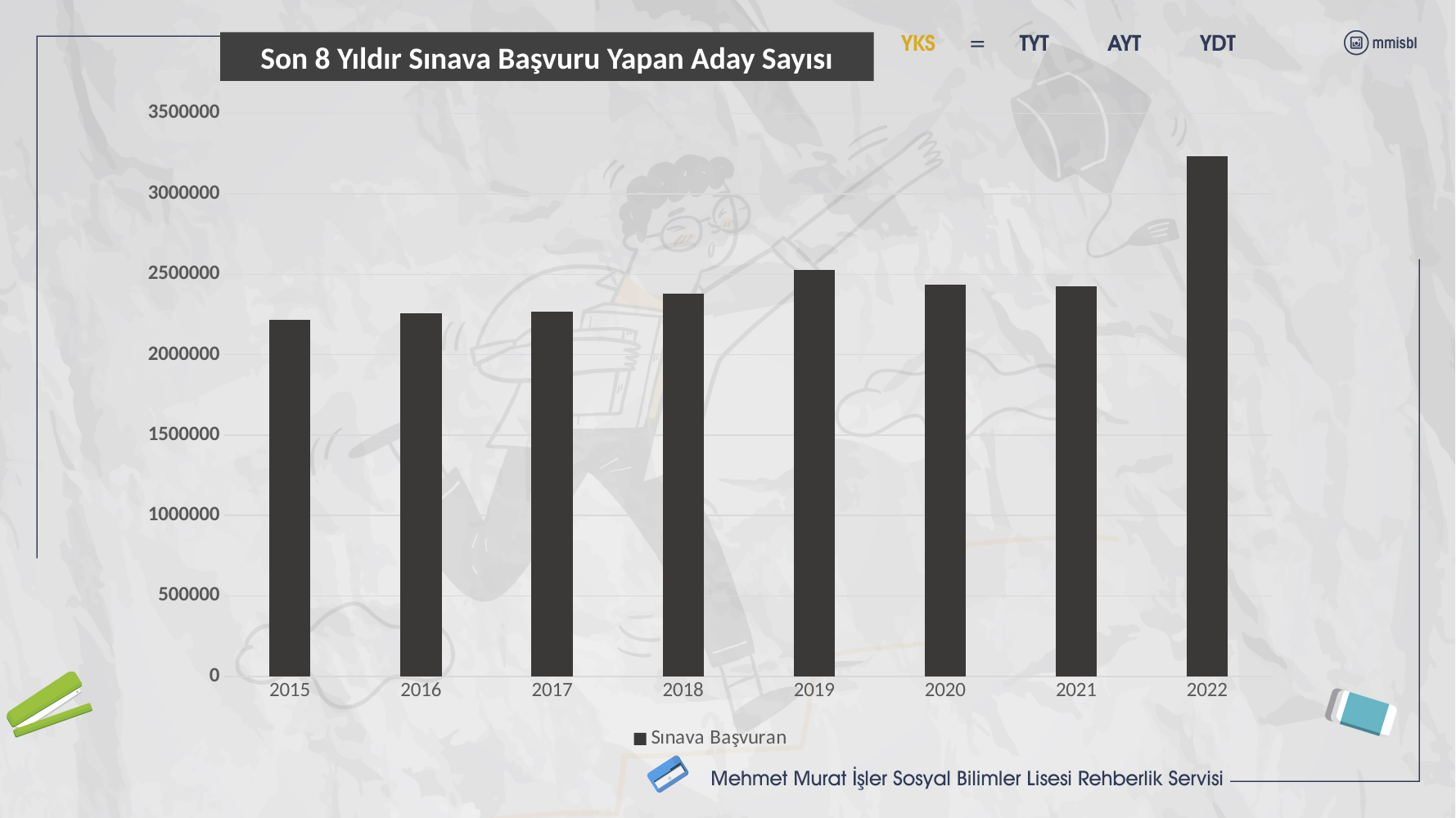
Which year has the highest number of applicants in the chart? 2022 Is the value for 2018 greater or less than 2500000? less What kind of chart is shown on the slide? bar chart How many years are shown on the x axis of the chart? 8 Is the value for 2022 greater or less than 3000000? greater What is the name of the series shown in the chart legend? Sınava Başvuran How many series does the chart legend list? 1 Which is larger, the value for 2019 or the value for 2018? 2019 Which is larger, the value for 2015 or the value for 2022? 2022 Is the value for 2022 greater or less than 3500000? less What is the title of the chart? Son 8 Yıldır Sınava Başvuru Yapan Aday Sayısı